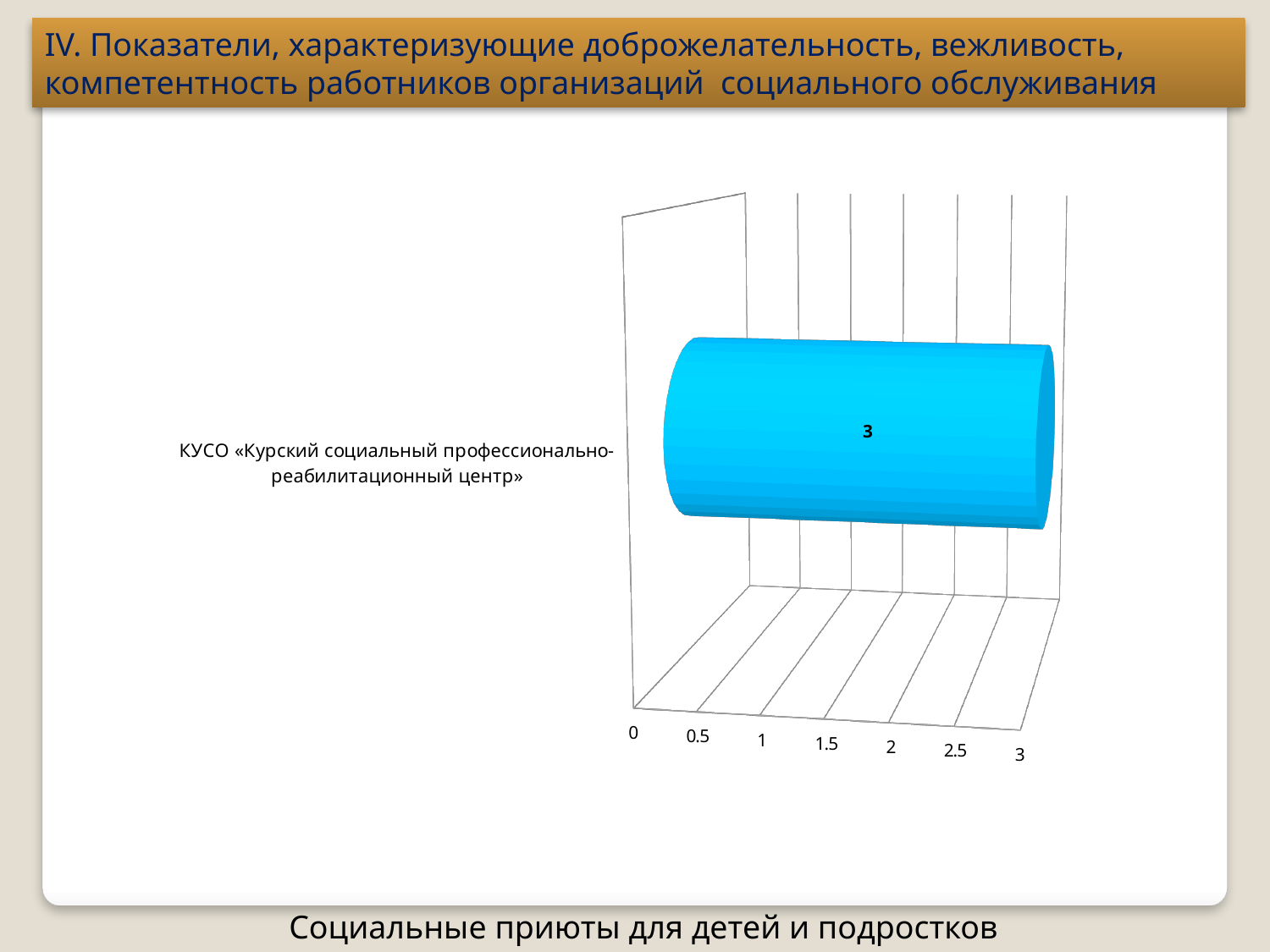
Is the value for КУСО «Курский социальный профессионально-реабилитационный центр» greater or less than 2? greater What is the value shown for КУСО «Курский социальный профессионально-реабилитационный центр»? 3 Which category is plotted in the chart? КУСО «Курский социальный профессионально-реабилитационный центр» Is the value for КУСО «Курский социальный профессионально-реабилитационный центр» greater or less than 1.5? greater What kind of chart is shown on the slide? bar chart What is the maximum value shown on the value axis of the chart? 3 How many categories are plotted in the chart? 1